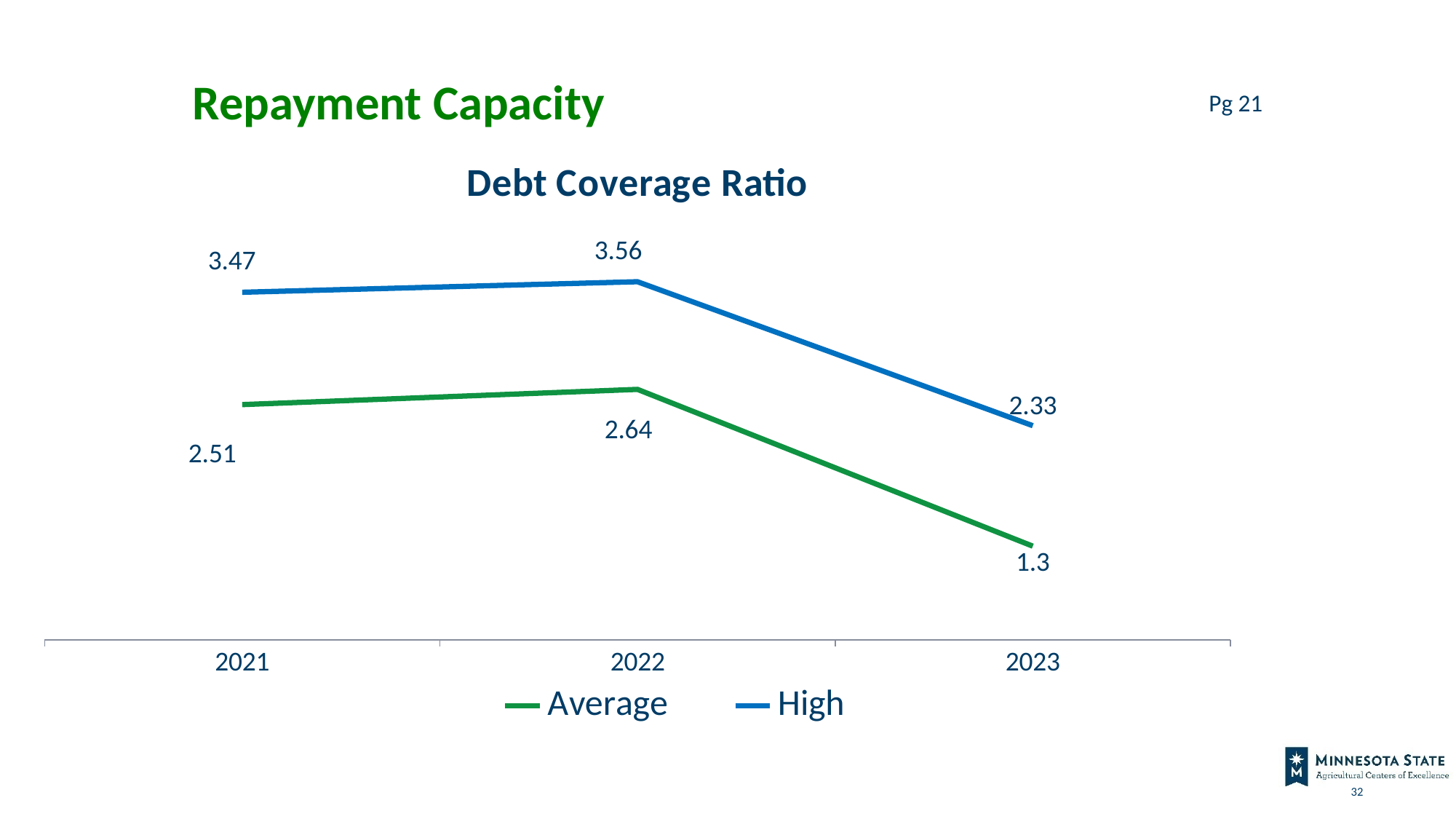
How many years are shown on the x axis? 3 What is the High debt coverage ratio in 2023? 2.33 What is the High debt coverage ratio in 2022? 3.56 What kind of chart is this? Line chart What is the difference between the High and Average values in 2022? 0.92 In which year is the High series at its highest? 2022 Which is larger, the Average value in 2022 or the Average value in 2021? 2022 What is the Average debt coverage ratio in 2023? 1.3 How many series does the legend list? 2 By how much did the High value fall from 2022 to 2023? 1.23 What is the Average debt coverage ratio in 2021? 2.51 In which year is the Average series at its lowest? 2023